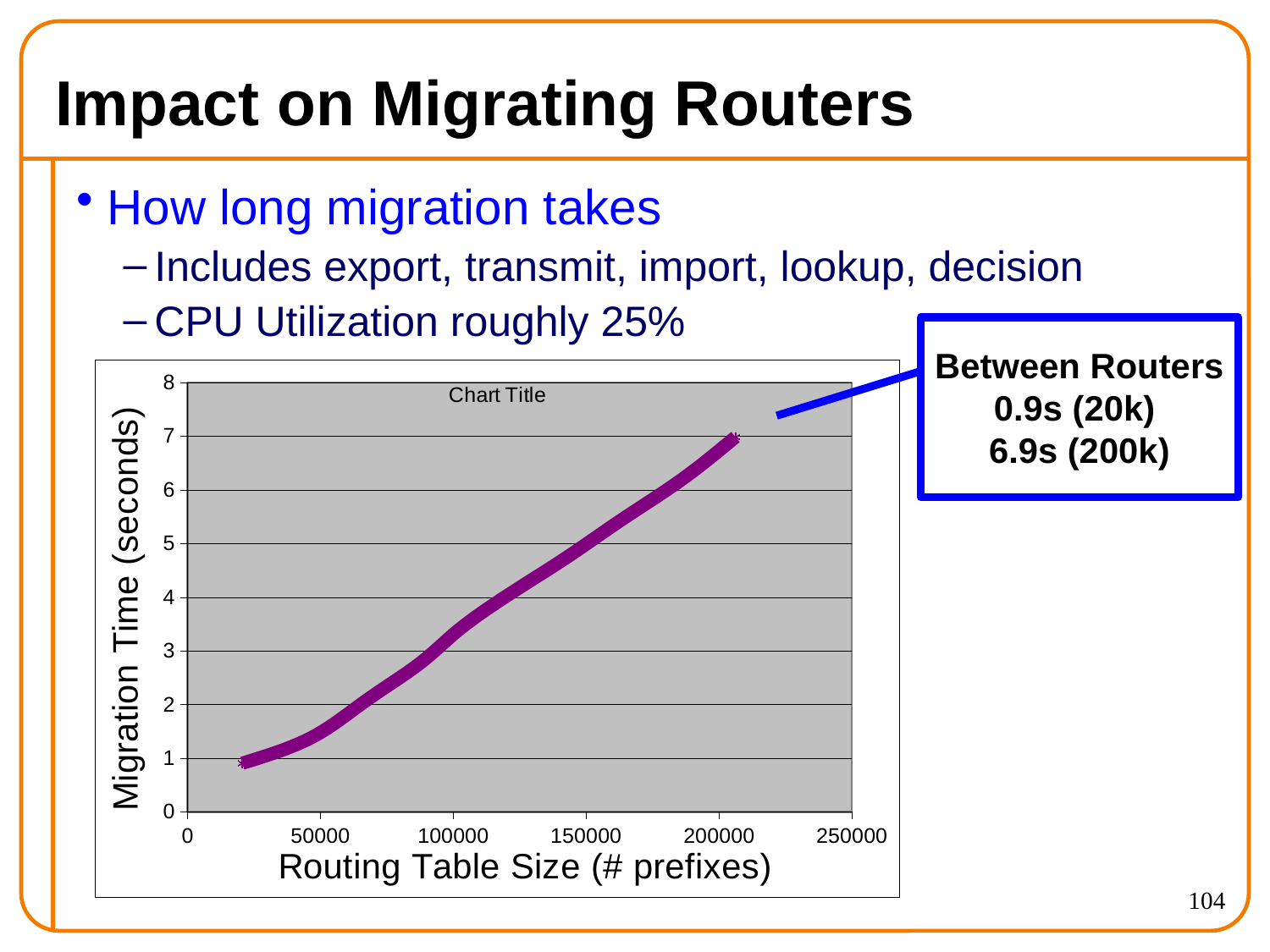
Is the migration time at a routing table size of 50000 greater or less than 2 seconds? less What kind of chart is shown on the slide? line chart Is the migration time at a routing table size of 150000 greater or less than 4 seconds? greater What is the label of the y axis of the chart? Migration Time (seconds) What is the difference in migration time between the 200k and 20k routing table sizes? 6.0s What is the migration time for a routing table size of 200k prefixes? 6.9s Does migration time rise or fall as routing table size increases along the x axis? rise Is the migration time at a routing table size of 100000 greater or less than 4 seconds? less What is the migration time for a routing table size of 20k prefixes? 0.9s What is the label of the x axis of the chart? Routing Table Size (# prefixes) Which routing table size has the larger migration time, 20k or 200k? 200k